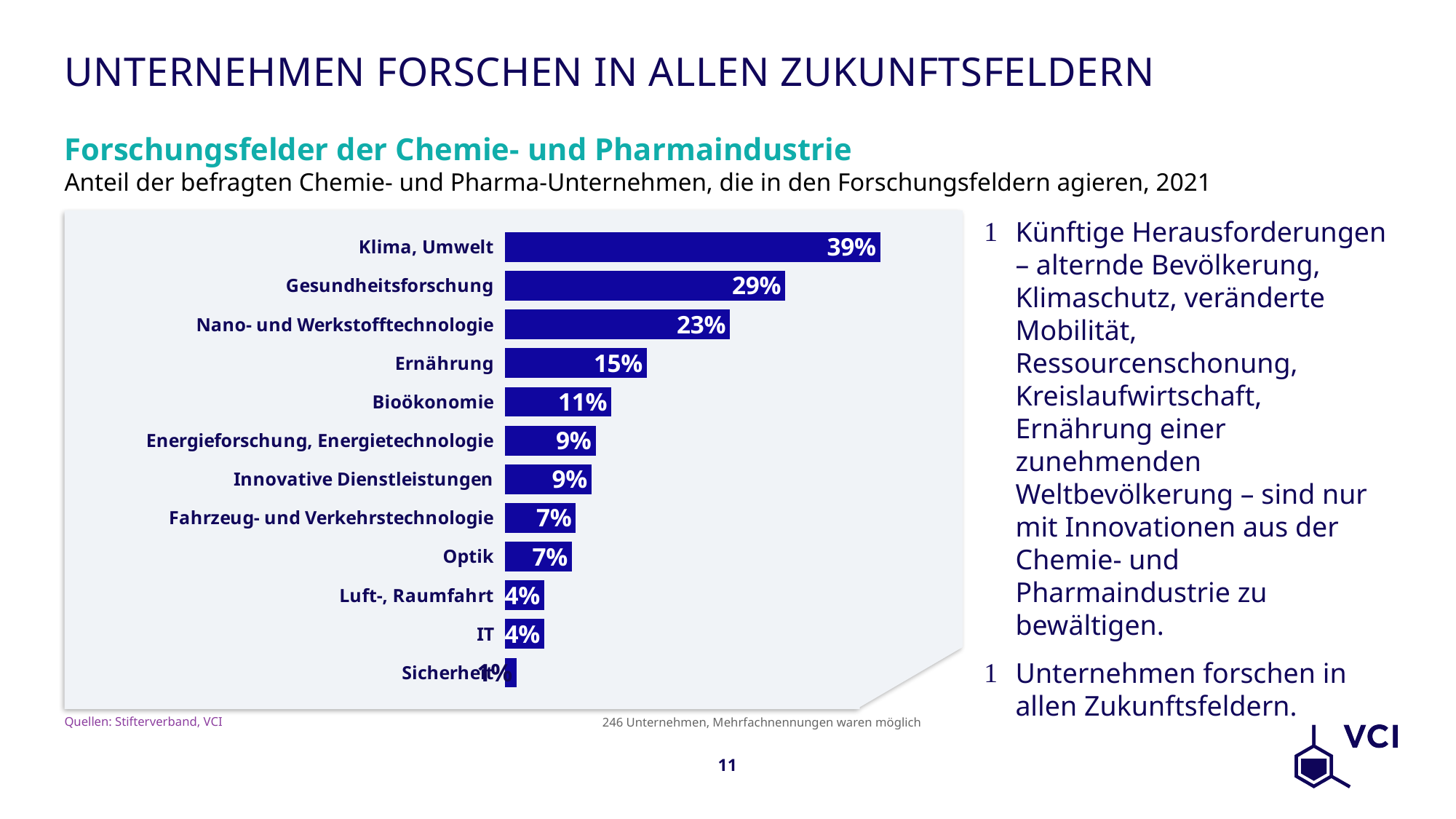
What is the title of the chart? Forschungsfelder der Chemie- und Pharmaindustrie What is the value for Nano- und Werkstofftechnologie? 23% What is the value for Bioökonomie? 11% How many research fields are shown in the chart? 12 Which research field has the highest share? Klima, Umwelt What is the difference between the values for Klima, Umwelt and Gesundheitsforschung? 10% What is the value for Gesundheitsforschung? 29% Which is larger, the value for Ernährung or the value for Optik? Ernährung What is the value for Klima, Umwelt? 39% What is the value for Luft-, Raumfahrt? 4% What kind of chart is shown on the slide? Bar chart Which research field has the lowest share? Sicherheit